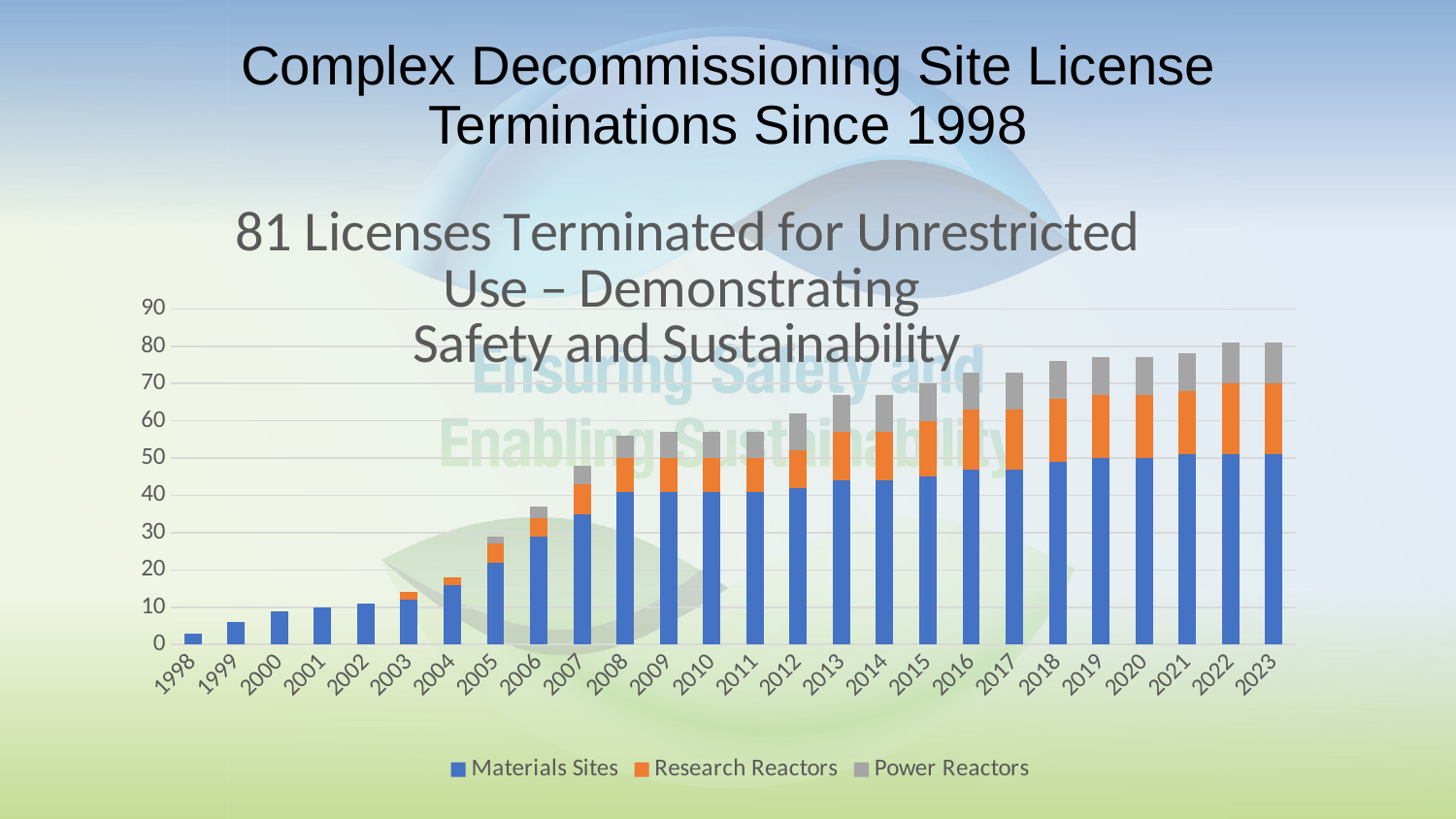
How many years are plotted along the x axis of the chart? 26 Is the total bar for 2003 greater or less than 20? less Is the total bar for 1998 greater or less than 10? less Is the total bar for 2023 greater or less than 70? greater What are the three series listed in the chart legend? Materials Sites, Research Reactors, Power Reactors Which series is shown in blue in the chart? Materials Sites Which year has the lowest total bar in the chart? 1998 How many series does the chart legend list? 3 Do the total bar heights generally rise or fall from 1998 to 2023? Rise What kind of chart is shown on the slide? Stacked bar chart Which year has the larger total bar, 2000 or 2010? 2010